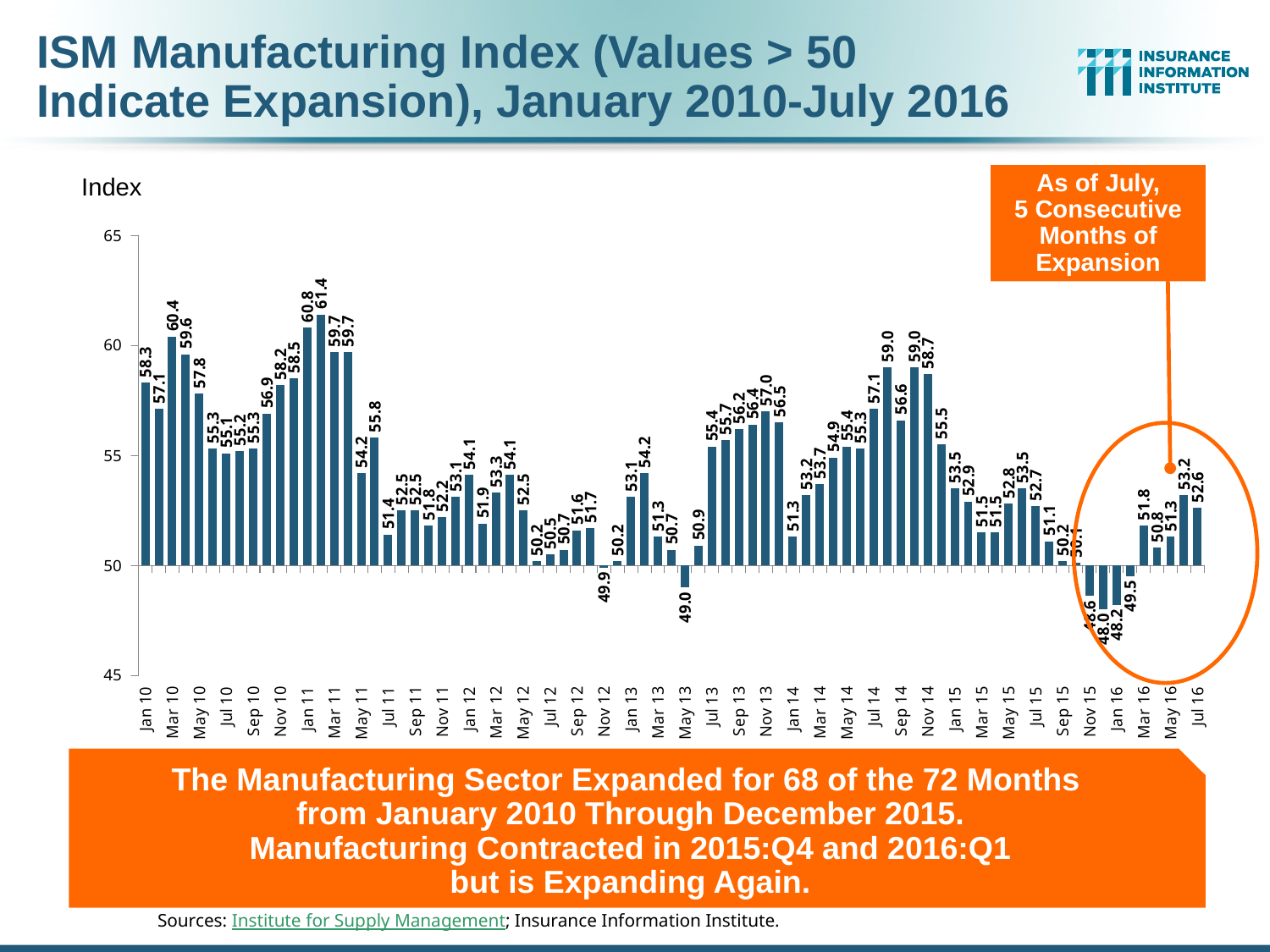
What is the highest index value shown on the chart? 61.4 What is the ISM Manufacturing Index value for Jan 10? 58.3 Do the index values rise or fall from Jul 13 to Nov 13? rise What is the ISM Manufacturing Index value for Jul 16? 52.6 According to the callout on the chart, as of July how many consecutive months of expansion have there been? 5 Is the index value for Jan 16 greater or less than 50? less What kind of chart is shown on the slide? bar chart What is the difference between the index values for Jan 10 and Jul 16? 5.7 What is the ISM Manufacturing Index value for Mar 10? 60.4 What is the ISM Manufacturing Index value for Jan 16? 48.2 What is the lowest index value shown on the chart? 48.0 Which is larger, the index value for Mar 10 or for Mar 16? Mar 10